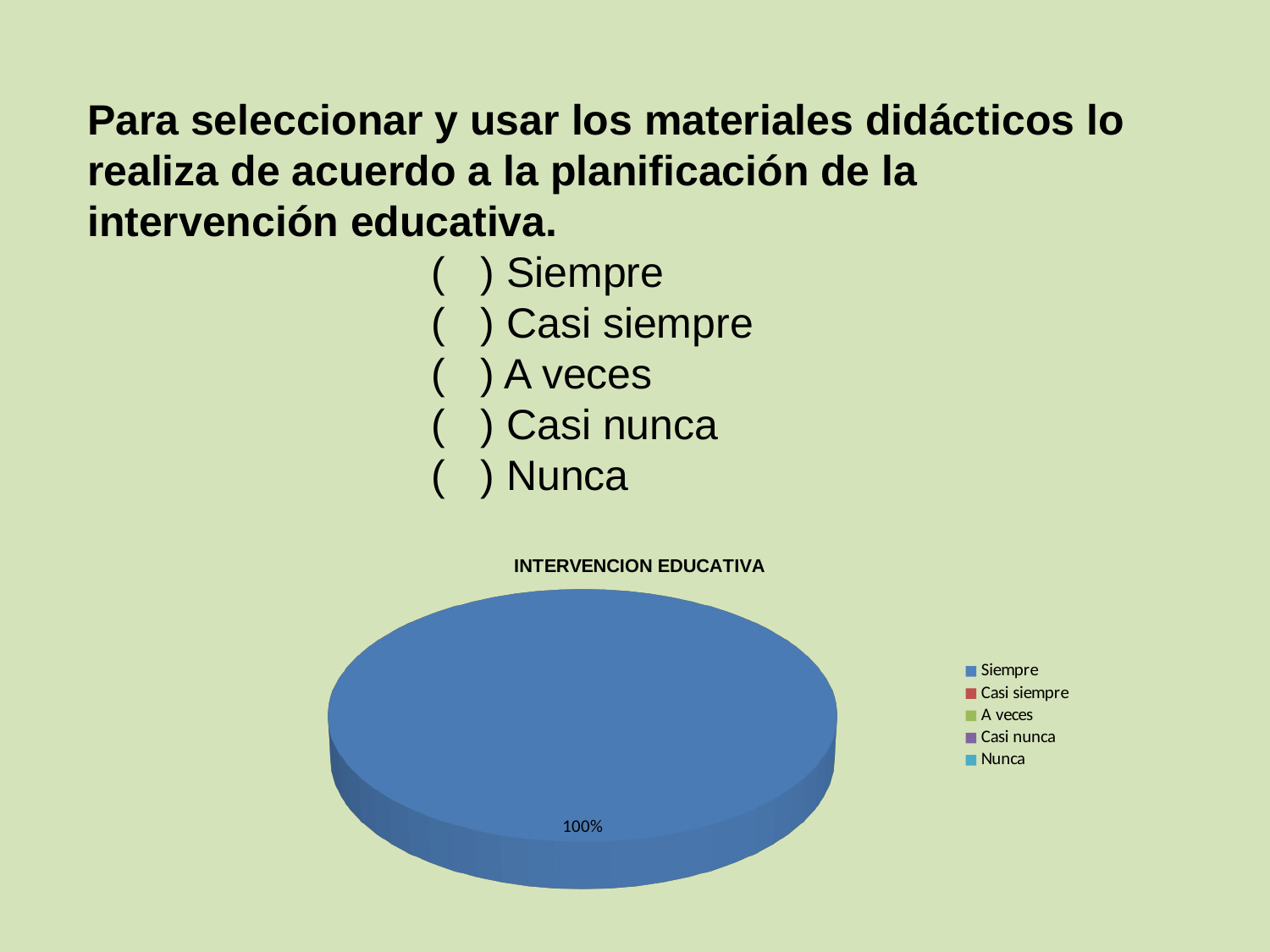
What share of the pie does the Siempre slice take? 100% How many entries does the chart legend list? 5 Which legend entry is shown in blue, matching the only visible slice? Siempre What is the data label printed on the pie? 100% What kind of chart is shown on the slide? pie chart Which category has the largest share of the pie? Siempre Which is larger, the share for Siempre or the share for Nunca? Siempre What is the title of the chart? INTERVENCION EDUCATIVA Is the share for Siempre greater or less than 50%? greater